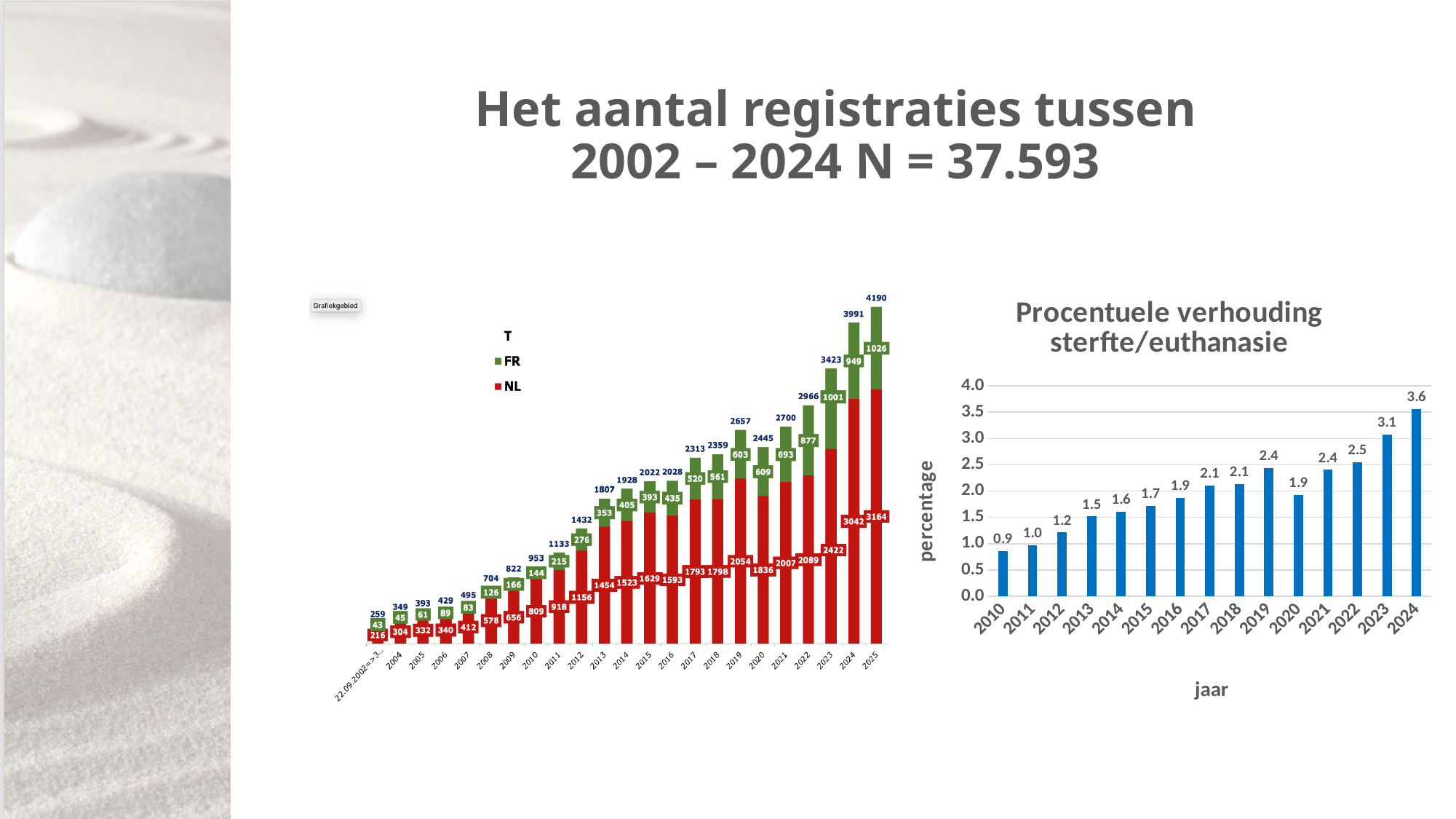
In the right chart 'Procentuele verhouding sterfte/euthanasie', what is the percentage for 2024? 3.6 In the right chart 'Procentuele verhouding sterfte/euthanasie', how many years are shown on the x axis? 15 In the right chart 'Procentuele verhouding sterfte/euthanasie', is the value for 2020 greater or less than the value for 2019? less How many series does the legend of the left stacked bar chart list? 3 In the left stacked bar chart, which year has the highest total? 2025 In the right chart 'Procentuele verhouding sterfte/euthanasie', which year has the lowest percentage? 2010 In the left stacked bar chart, what is the total for 2024? 3991 In the left stacked bar chart, what is the NL value for 2025? 3164 In the right chart 'Procentuele verhouding sterfte/euthanasie', what is the difference between the 2024 and 2023 values? 0.5 In the left stacked bar chart, what is the difference between the NL values for 2024 and 2023? 620 In the left stacked bar chart, what is the FR value for 2023? 1001 What type of chart is the right chart 'Procentuele verhouding sterfte/euthanasie'? bar chart